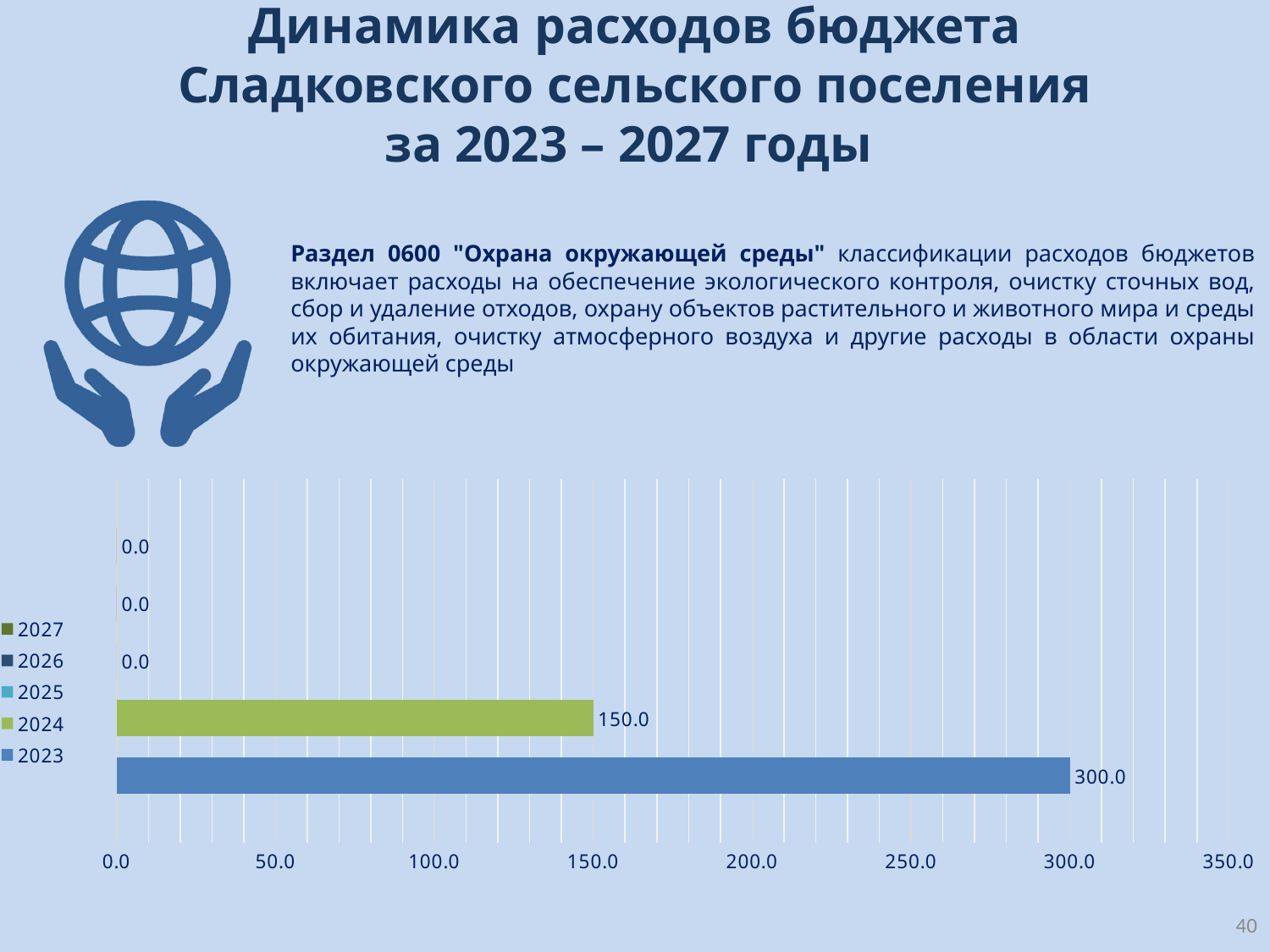
Какое значение показано для 2023 года на диаграмме? 300.0 На сколько значение 2023 года больше значения 2024 года? 150.0 Какое значение больше: за 2023 год или за 2024 год? 2023 Какое значение показано для 2025 года на диаграмме? 0.0 Какое значение показано для 2027 года на диаграмме? 0.0 Значение для 2024 года больше или меньше 200.0? меньше Какой год имеет наибольшее значение на диаграмме? 2023 Сколько рядов (годов) перечислено в легенде диаграммы? 5 Значение для 2023 года больше или меньше 250.0? больше Какое значение показано для 2024 года на диаграмме? 150.0 Какого типа эта диаграмма? Столбчатая (линейчатая) диаграмма Какое максимальное значение показано на горизонтальной оси диаграммы? 350.0